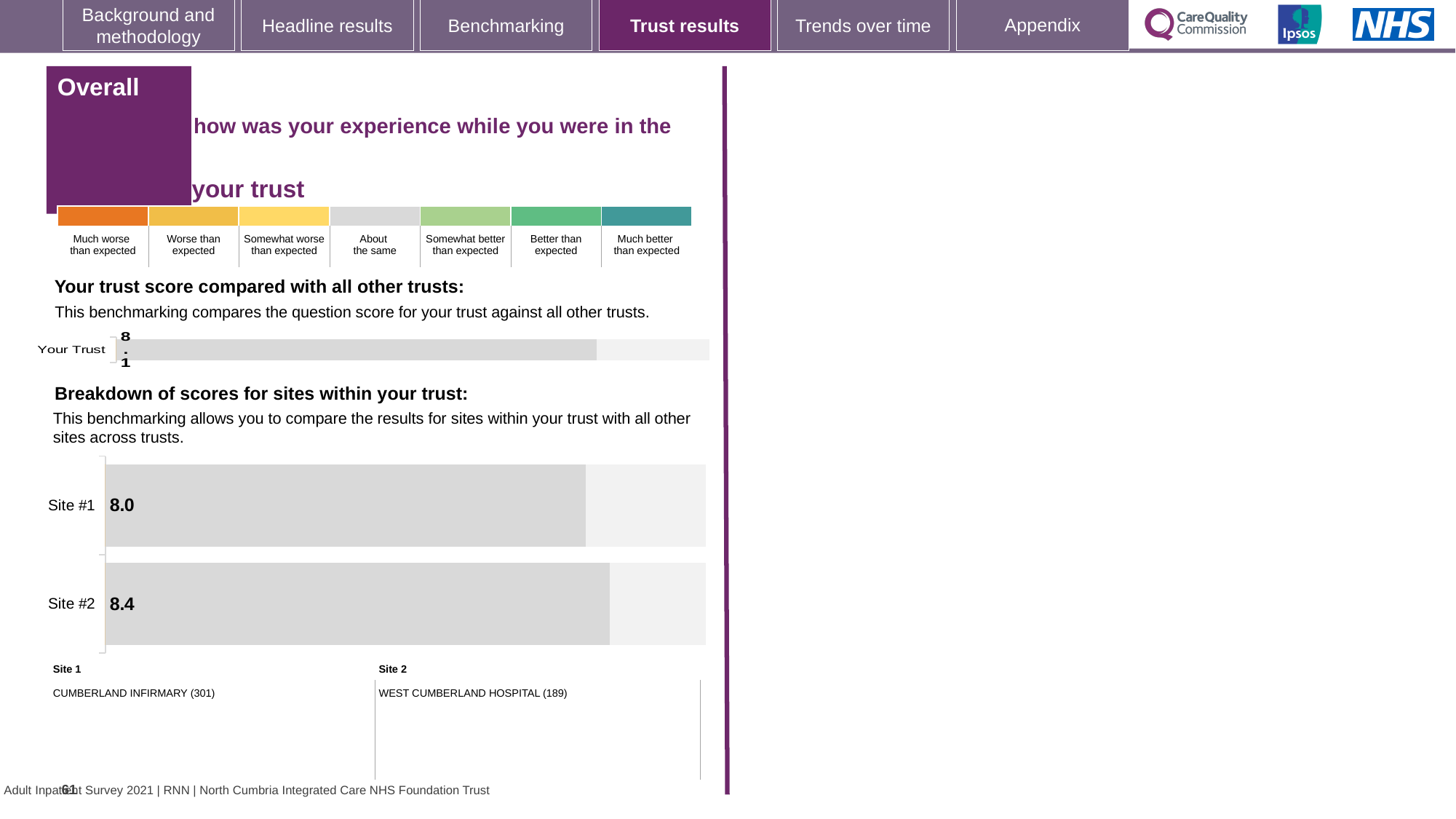
In the 'Breakdown of scores for sites within your trust' chart, which site has the higher score? Site #2 In the 'Breakdown of scores for sites within your trust' chart, what is the score for Site #2? 8.4 In the 'Your trust score compared with all other trusts' chart, what is the score for Your Trust? 8.1 According to the key below the site chart, which hospital is Site 1? CUMBERLAND INFIRMARY (301) Is the Your Trust score in the 'Your trust score compared with all other trusts' chart greater or less than the Site #2 score in the breakdown chart? less In the 'Breakdown of scores for sites within your trust' chart, what is the difference between the scores of Site #2 and Site #1? 0.4 In the 'Breakdown of scores for sites within your trust' chart, which site has the lower score? Site #1 In the 'Breakdown of scores for sites within your trust' chart, what is the score for Site #1? 8.0 What kind of chart is the 'Breakdown of scores for sites within your trust' chart? bar chart In the 'Breakdown of scores for sites within your trust' chart, is the score for Site #1 larger or smaller than the score for Site #2? smaller How many sites are shown in the 'Breakdown of scores for sites within your trust' chart? 2 How many bars are shown in the 'Your trust score compared with all other trusts' chart? 1